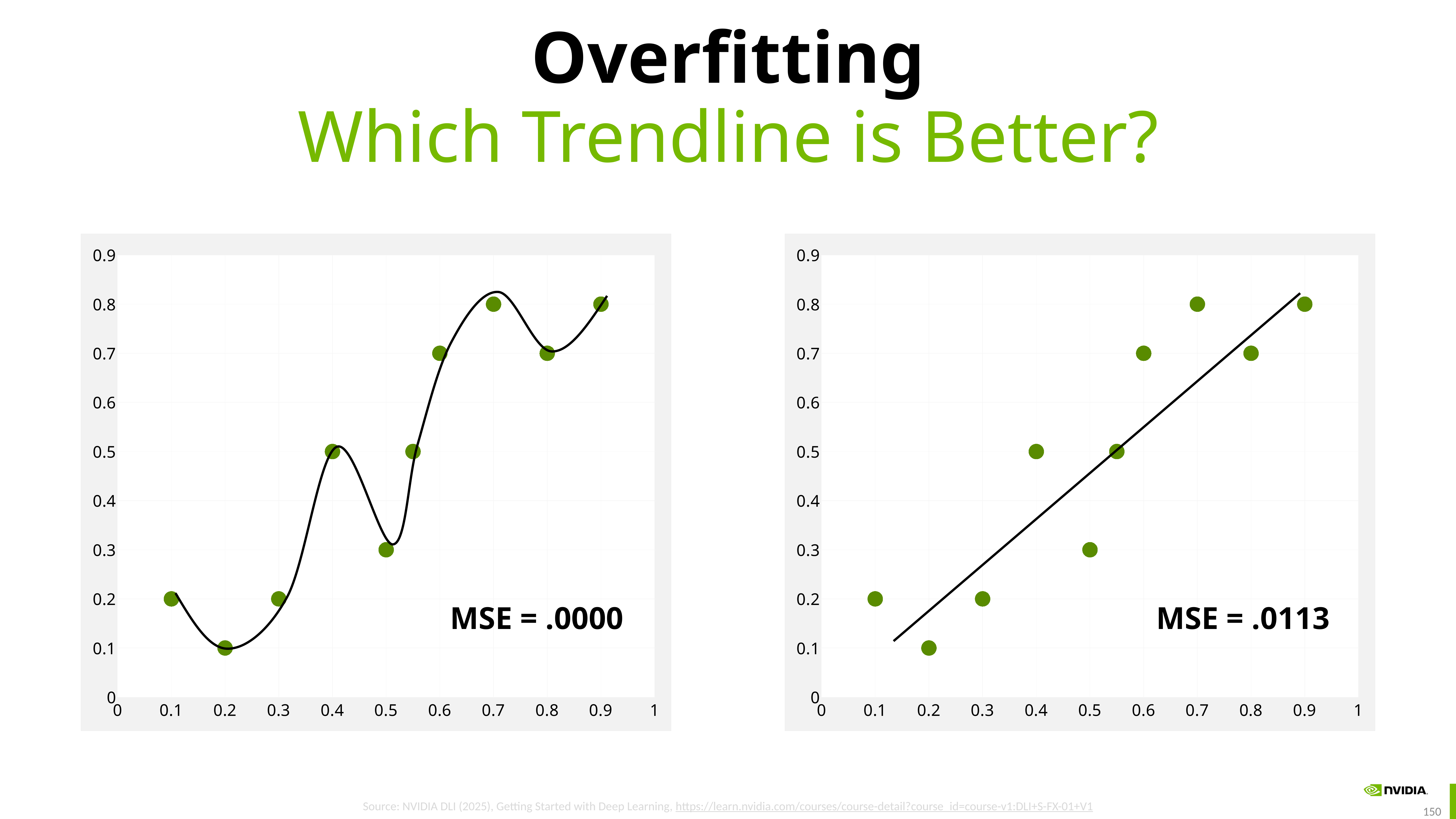
What MSE value is shown on the right chart? MSE = .0113 On the left chart, what is the y value of the point at x = 0.5? 0.3 On the right chart, what is the y value of the point at x = 0.7? 0.8 What kind of chart is the left chart? scatter chart On the left chart, what is the difference between the y values at x = 0.7 and x = 0.1? 0.6 How many data points are plotted on the right chart? 10 Do the y values on the right chart generally rise or fall as x increases? rise On the left chart, what is the y value of the point at x = 0.2? 0.1 On the right chart, which point has the larger y value: the one at x = 0.4 or the one at x = 0.5? x = 0.4 What MSE value is shown on the left chart? MSE = .0000 On the right chart, which x value has the lowest y value? 0.2 On the left chart, is the y value of the point at x = 0.6 greater or less than 0.5? greater